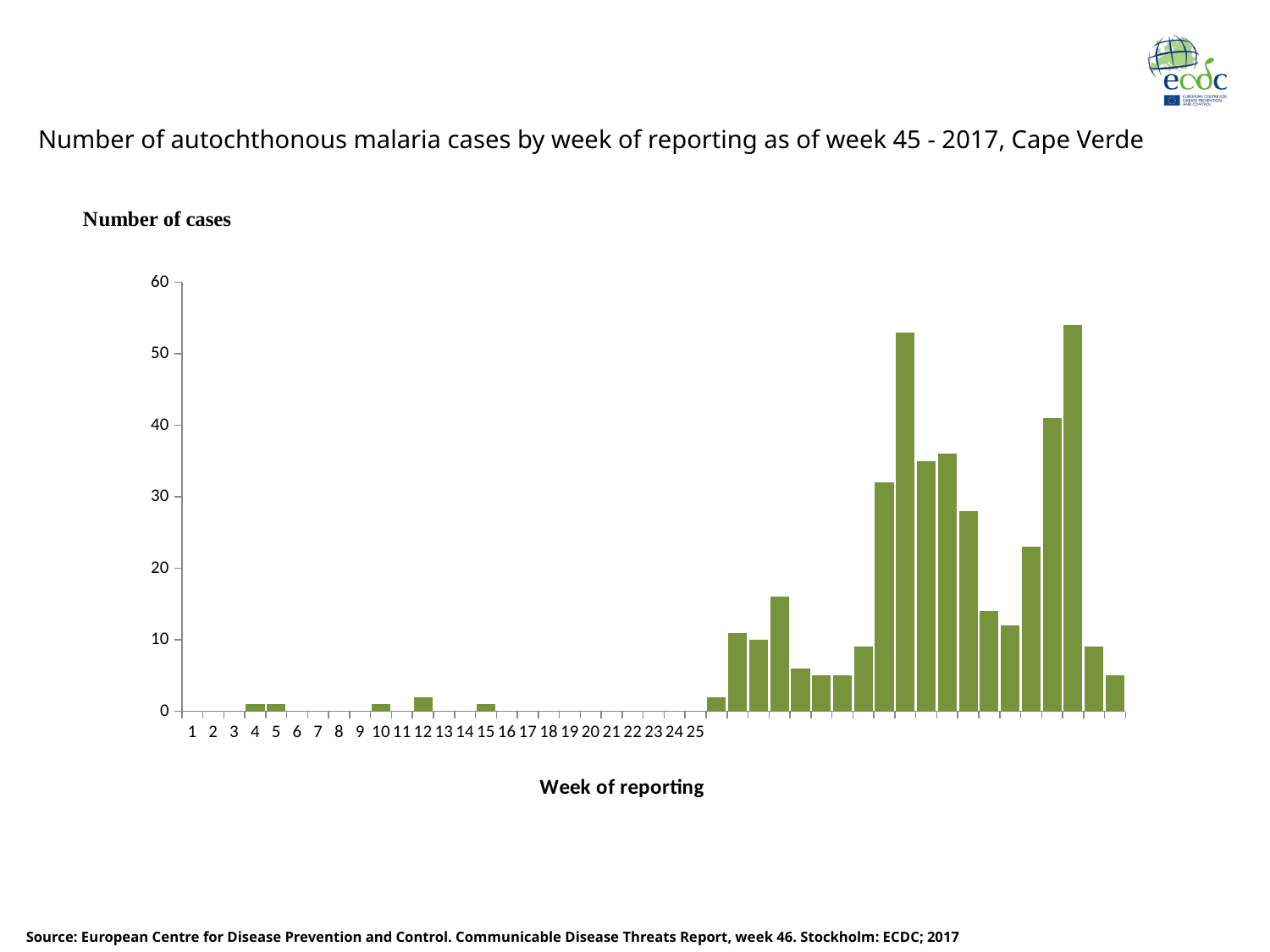
What is the title of the chart? Number of autochthonous malaria cases by week of reporting as of week 45 - 2017, Cape Verde Is the tallest bar in the chart greater or less than 60? less What kind of chart is shown on the slide? bar chart Do the number of cases generally rise or fall from the early weeks to the later weeks? rise Is the value for week 4 greater or less than 10? less Is the tallest bar in the chart greater or less than 50? greater What is the highest value shown on the y axis? 60 Which has more cases, week 10 or week 12? week 12 What is the label of the x axis? Week of reporting